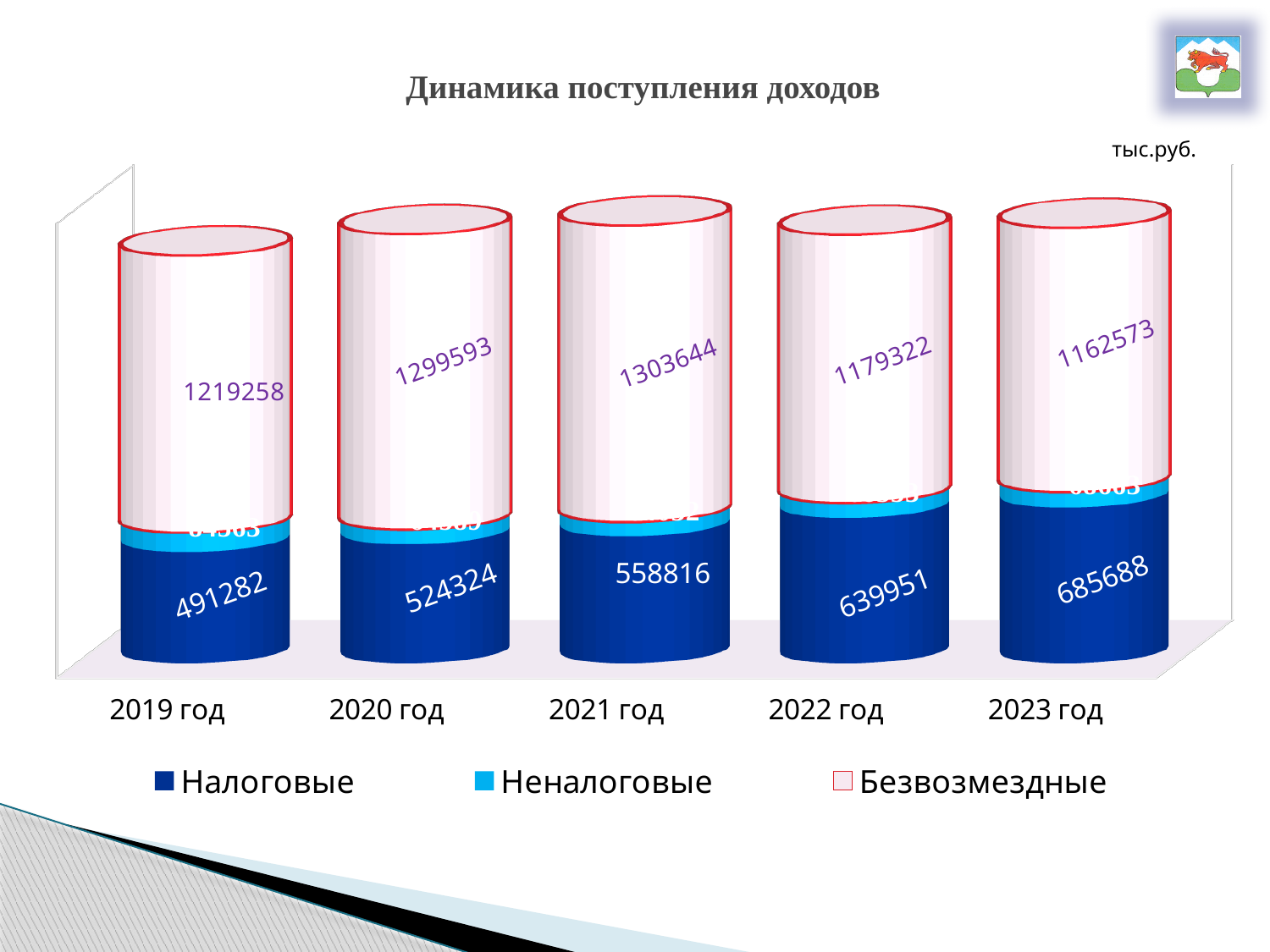
How many series does the legend list? 3 What kind of chart is shown on the slide? Stacked bar chart How many years are shown on the x axis? 5 What is the value of Налоговые for 2022 год? 639951 In which year is the Безвозмездные value the lowest? 2023 год What is the value of Налоговые for 2021 год? 558816 What is the value of Безвозмездные for 2020 год? 1299593 What is the difference between the Налоговые values for 2023 год and 2019 год? 194406 In which year is the Налоговые value the highest? 2023 год Which year has the larger Безвозмездные value, 2021 год or 2022 год? 2021 год In which year is the Безвозмездные value the highest? 2021 год Do the Налоговые values rise or fall from 2019 год to 2023 год? Rise